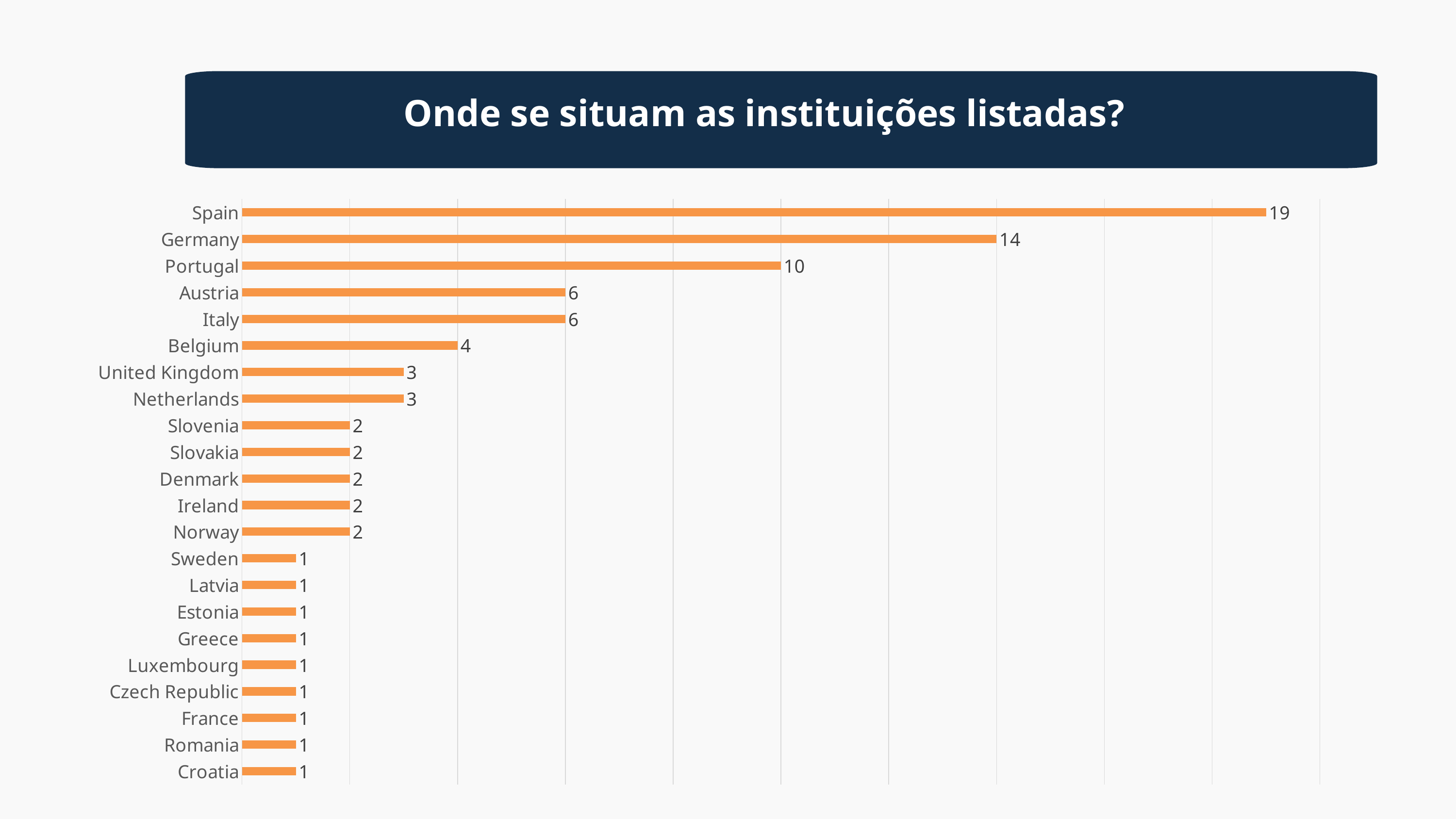
What is the value for Germany? 14 Which has a larger value, Germany or Portugal? Germany How many countries are shown in the chart? 22 Which country has the highest value? Spain What is the title of the slide? Onde se situam as instituições listadas? What is the difference between the values for Portugal and Austria? 4 What is the value for Portugal? 10 What is the value for Netherlands? 3 What is the value for Spain? 19 What kind of chart is shown on the slide? Bar chart What is the value for Belgium? 4 What is the difference between the values for Spain and Germany? 5